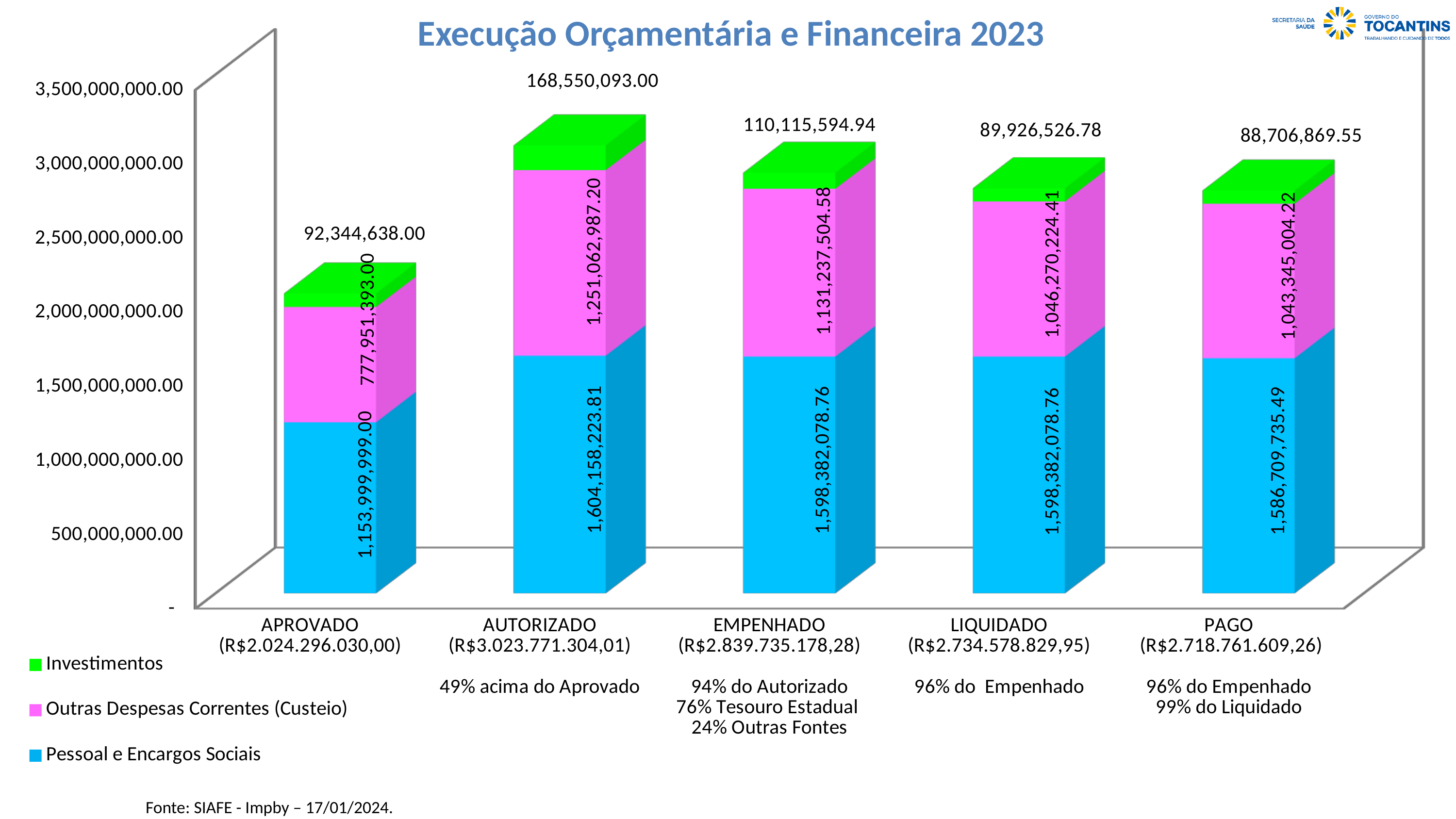
What kind of chart is shown on the slide? Stacked bar chart How many series does the legend list? 3 What is the value of Pessoal e Encargos Sociais for AUTORIZADO? 1,604,158,223.81 Which category has the lowest value for Pessoal e Encargos Sociais? APROVADO Is the total of the APROVADO bar greater or less than 2,500,000,000.00? less How many categories are shown on the x axis? 5 What is the value of Outras Despesas Correntes (Custeio) for PAGO? 1,043,345,004.22 What is the difference between the Investimentos values for AUTORIZADO and APROVADO? 76,205,455.00 What is the total of the LIQUIDADO bar as printed on the slide? R$2.734.578.829,95 What is the value of Investimentos for EMPENHADO? 110,115,594.94 Which is larger: Outras Despesas Correntes (Custeio) for APROVADO or for PAGO? PAGO Which category has the highest value for Investimentos? AUTORIZADO